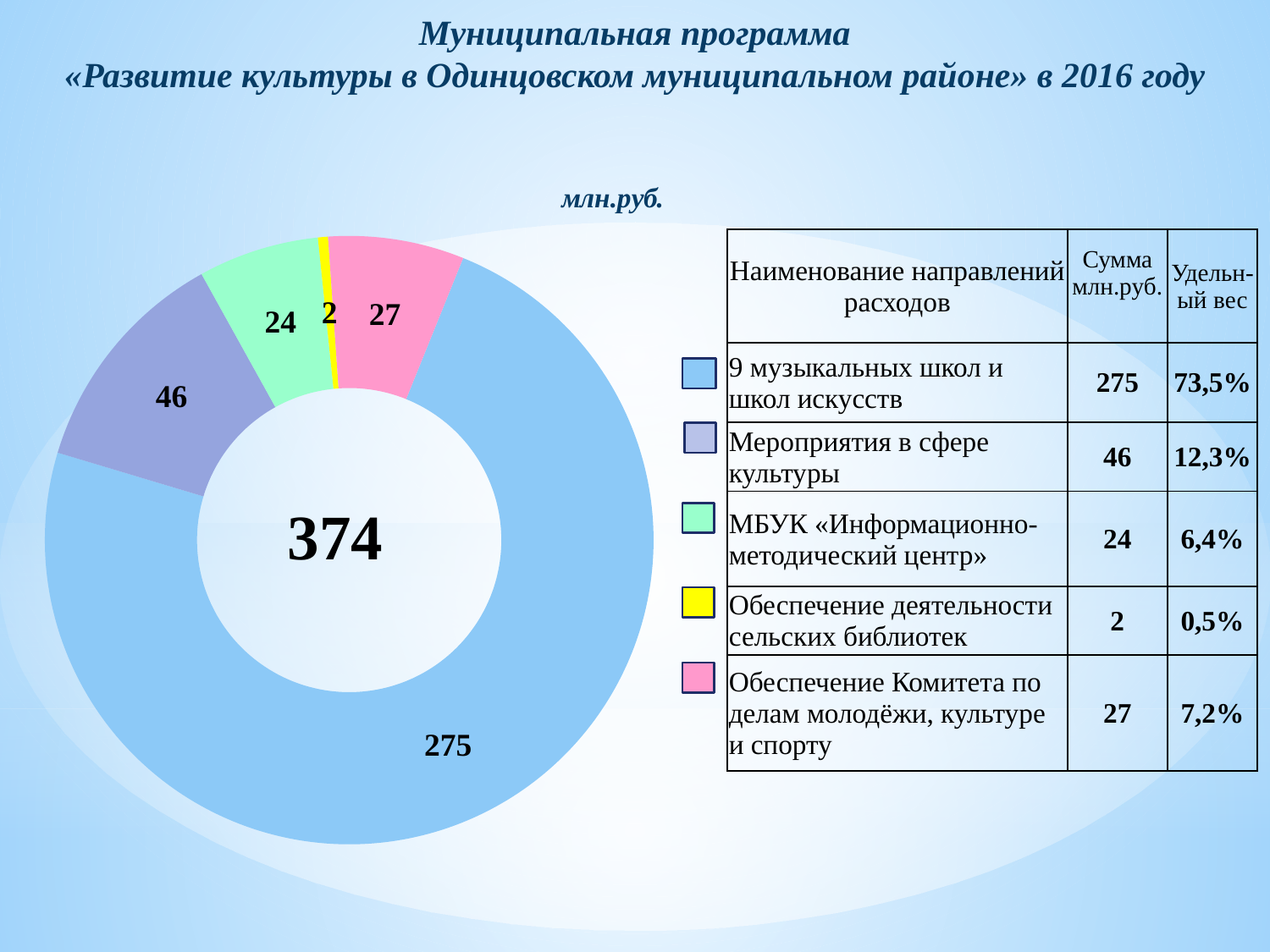
What is the value (млн.руб.) for «Мероприятия в сфере культуры»? 46 How many slices does the doughnut chart have? 5 What is the total shown in the centre of the doughnut chart? 374 What share of the total does «9 музыкальных школ и школ искусств» account for? 73,5% What is the value (млн.руб.) for «Обеспечение деятельности сельских библиотек»? 2 Which is larger: the value for «Обеспечение Комитета по делам молодёжи, культуре и спорту» or for «МБУК «Информационно-методический центр»»? Обеспечение Комитета по делам молодёжи, культуре и спорту What colour is the slice for «Обеспечение деятельности сельских библиотек»? yellow Which category has the largest slice in the doughnut chart? 9 музыкальных школ и школ искусств Which category has the smallest slice in the doughnut chart? Обеспечение деятельности сельских библиотек What is the value (млн.руб.) for «9 музыкальных школ и школ искусств»? 275 What is the difference between the values for «Мероприятия в сфере культуры» and «МБУК «Информационно-методический центр»»? 22 What kind of chart is shown on the slide? doughnut (pie) chart